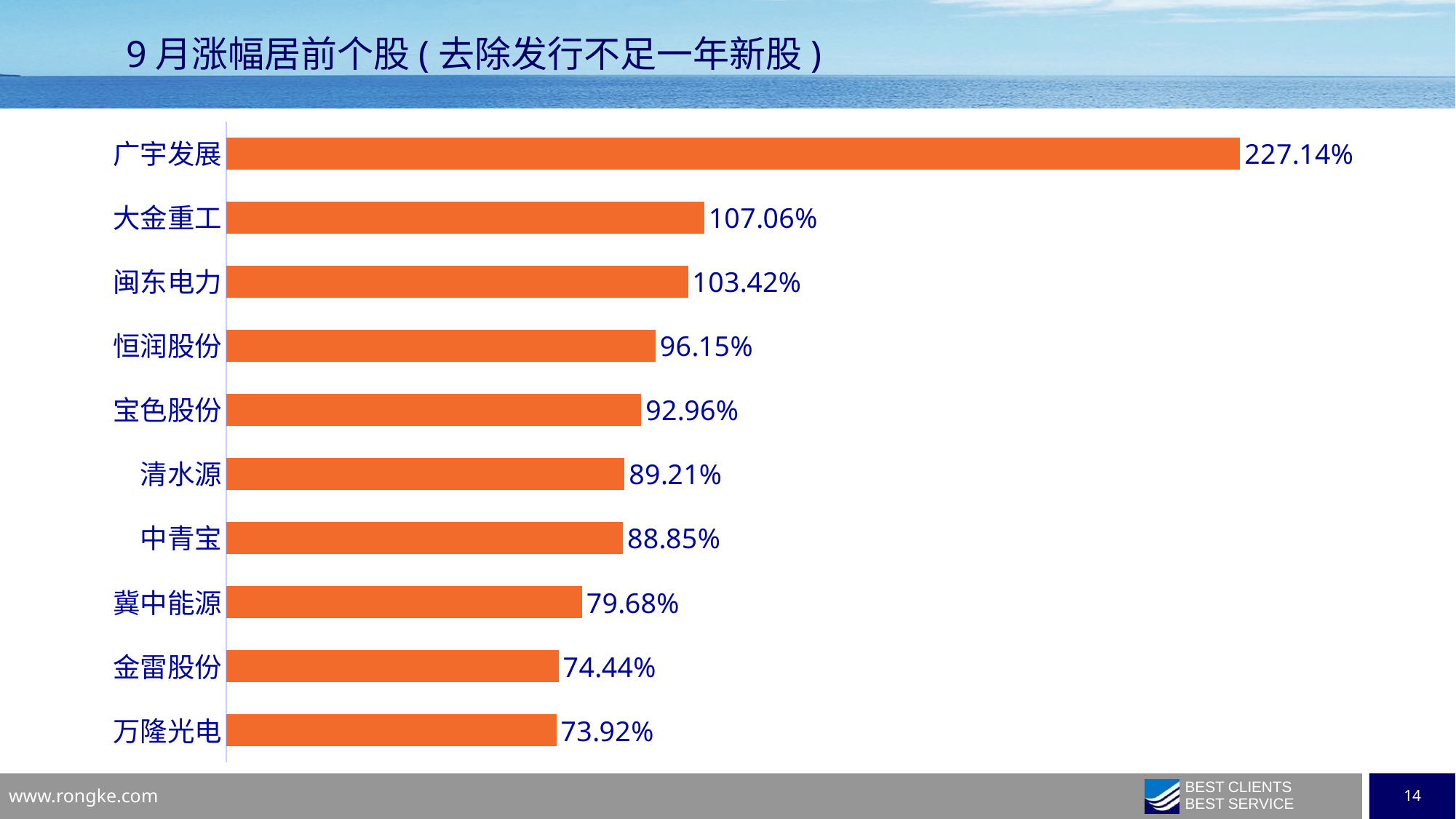
What is the value for 闽东电力? 103.42% What is the difference between the values for 恒润股份 and 宝色股份? 3.19% Which stock has the lowest value? 万隆光电 What is the value for 冀中能源? 79.68% Which is larger, the value for 清水源 or the value for 金雷股份? 清水源 What is the value for 广宇发展? 227.14% How many stocks are shown in the chart? 10 Which is larger, the value for 大金重工 or the value for 闽东电力? 大金重工 What is the difference between the values for 广宇发展 and 大金重工? 120.08% What is the title of the chart? 9月涨幅居前个股（去除发行不足一年新股） What kind of chart is shown on the slide? bar chart Which stock has the highest value? 广宇发展